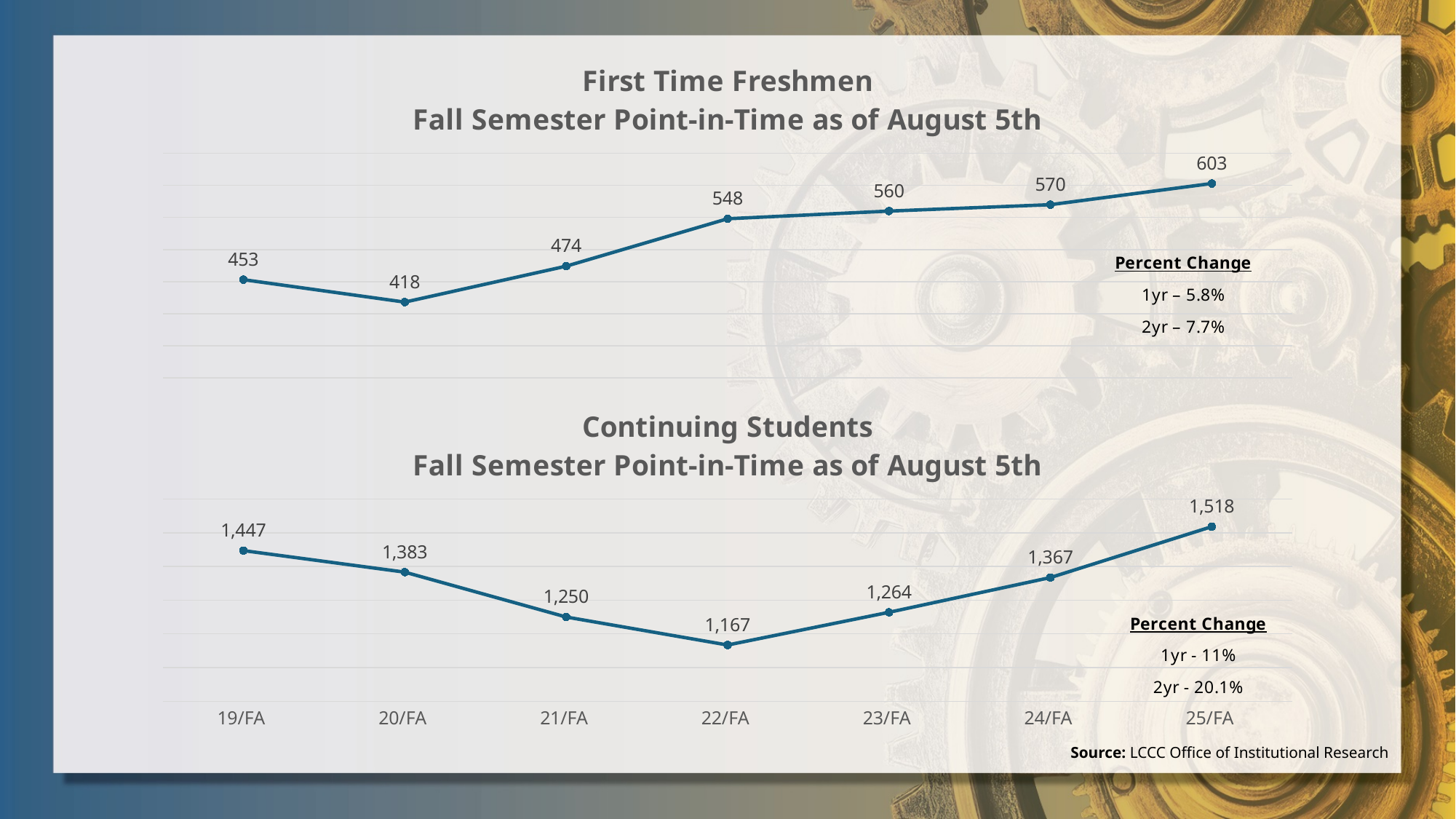
In the First Time Freshmen chart, what kind of chart is shown? line chart In the First Time Freshmen chart, what is the difference between the values for 25/FA and 24/FA? 33 In the Continuing Students chart, which term has the highest value? 25/FA In the First Time Freshmen chart, which term has the lowest value? 20/FA In the First Time Freshmen chart, what is the 1yr percent change shown? 5.8% In the Continuing Students chart, what is the difference between the values for 25/FA and 24/FA? 151 In the Continuing Students chart, what is the value for 21/FA? 1,250 In the Continuing Students chart, which is larger, the value for 19/FA or the value for 24/FA? 19/FA How many terms are plotted in the Continuing Students chart? 7 In the First Time Freshmen chart, what is the value for 22/FA? 548 In the Continuing Students chart, which term has the lowest value? 22/FA In the First Time Freshmen chart, which term has the highest value? 25/FA